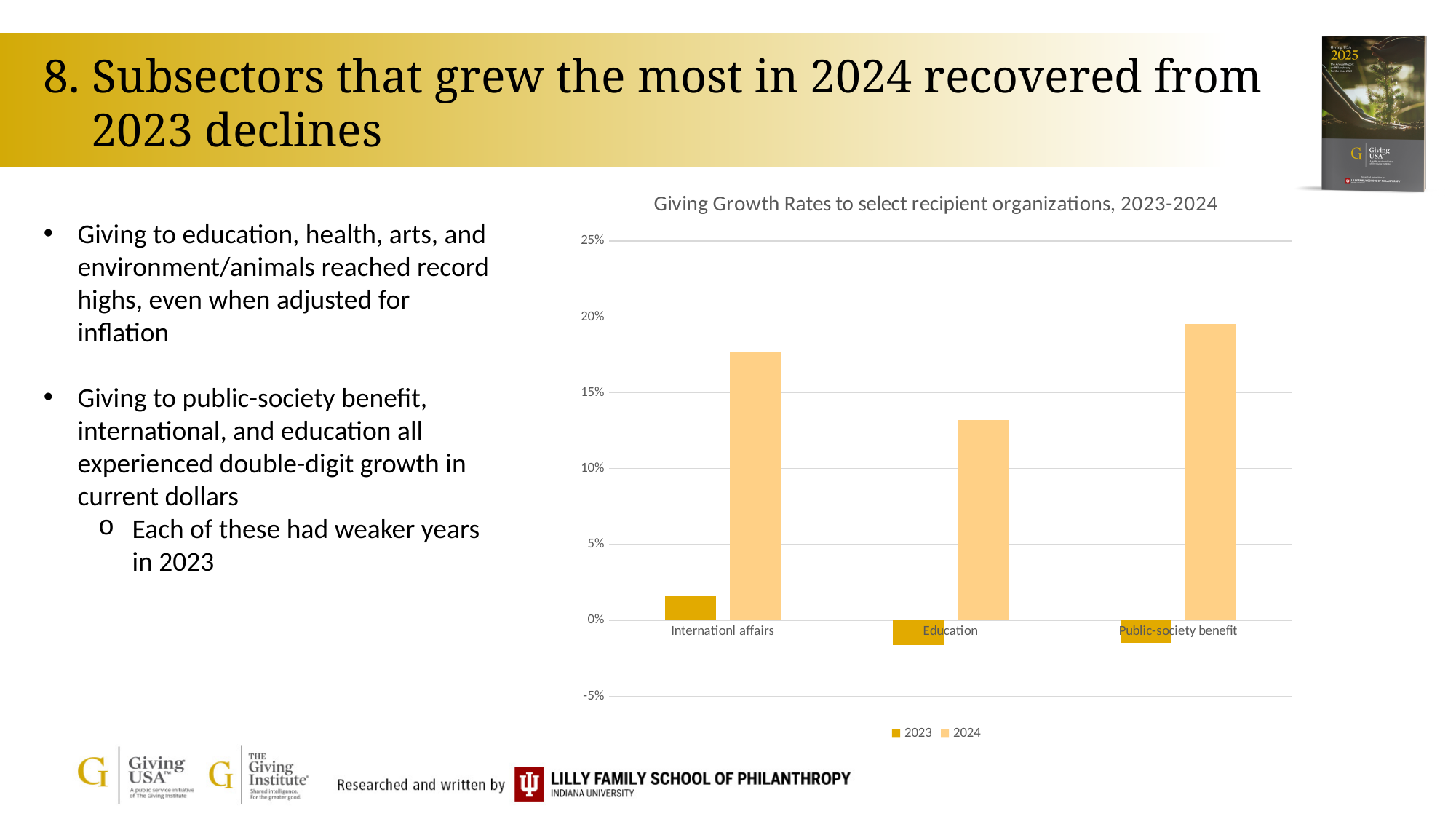
Which category has the highest 2023 growth rate? Internationl affairs Which series is shown in the darker gold colour in the legend? 2023 What kind of chart is shown on the slide? Bar chart Which category has the highest 2024 growth rate? Public-society benefit Which category has the lowest 2024 growth rate? Education Which is larger: the 2024 value for Internationl affairs or the 2024 value for Education? Internationl affairs Is the 2023 value for Education greater or less than 0%? less Is the 2024 value for Education greater or less than 15%? less How many recipient organization categories are shown on the x axis? 3 How many series does the chart's legend list? 2 What is the title of the chart? Giving Growth Rates to select recipient organizations, 2023-2024 Is the 2024 value for Public-society benefit greater or less than 15%? greater